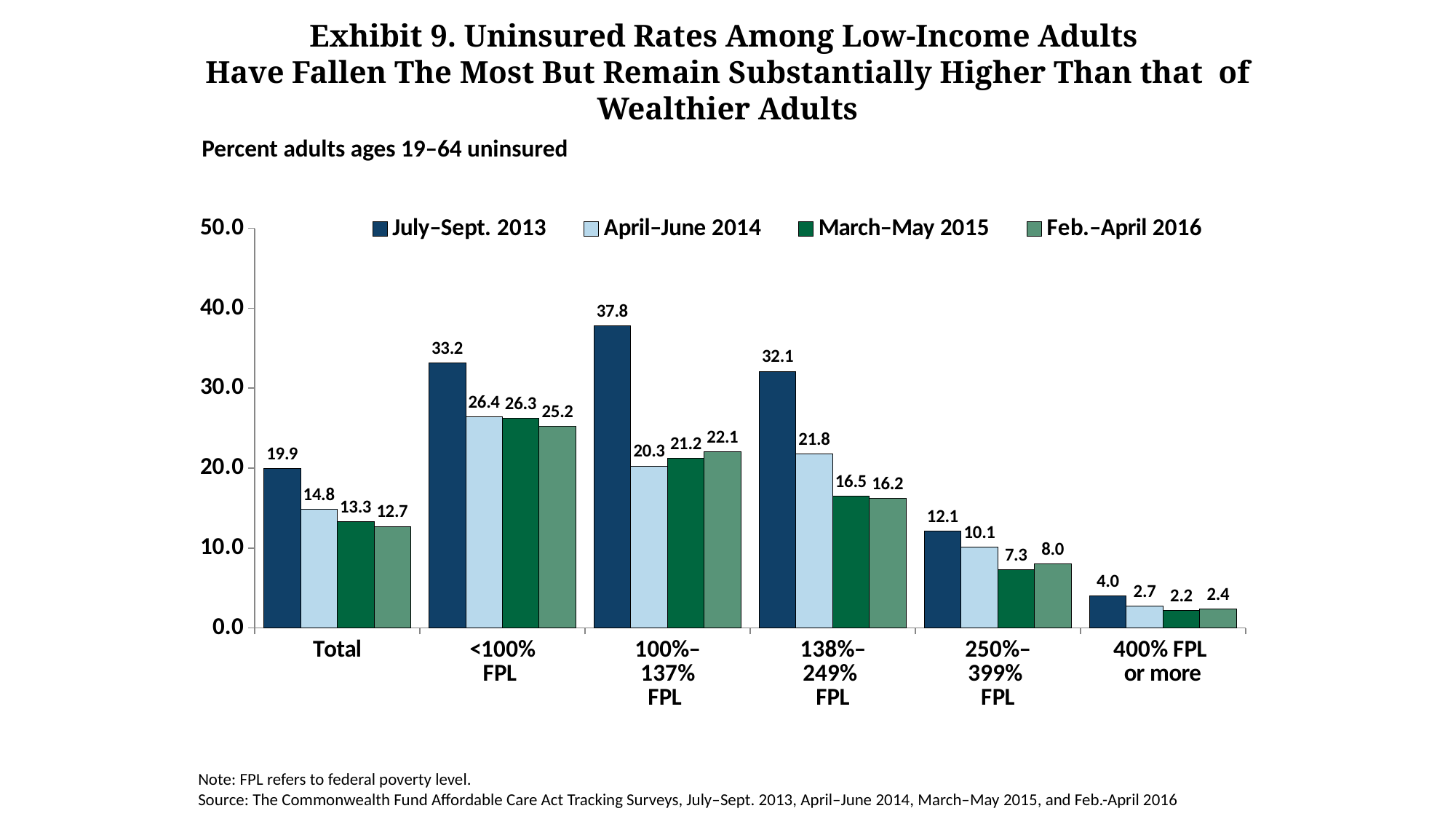
What is the uninsured rate for 400% FPL or more in March–May 2015? 2.2 How many income categories are shown on the x axis? 6 What is the uninsured rate for the Total category in July–Sept. 2013? 19.9 Is the July–Sept. 2013 value for <100% FPL greater or less than 30.0? greater Which income category has the highest uninsured rate in July–Sept. 2013? 100%–137% FPL What kind of chart is shown on the slide? Bar chart Which income category has the lowest uninsured rate in April–June 2014? 400% FPL or more How many series does the legend list? 4 What is the uninsured rate for 100%–137% FPL in Feb.–April 2016? 22.1 Which is larger for 250%–399% FPL: the March–May 2015 value or the Feb.–April 2016 value? Feb.–April 2016 Do the uninsured rates for the Total category rise or fall from July–Sept. 2013 to Feb.–April 2016? Fall What is the difference between the July–Sept. 2013 and Feb.–April 2016 uninsured rates for 138%–249% FPL? 15.9